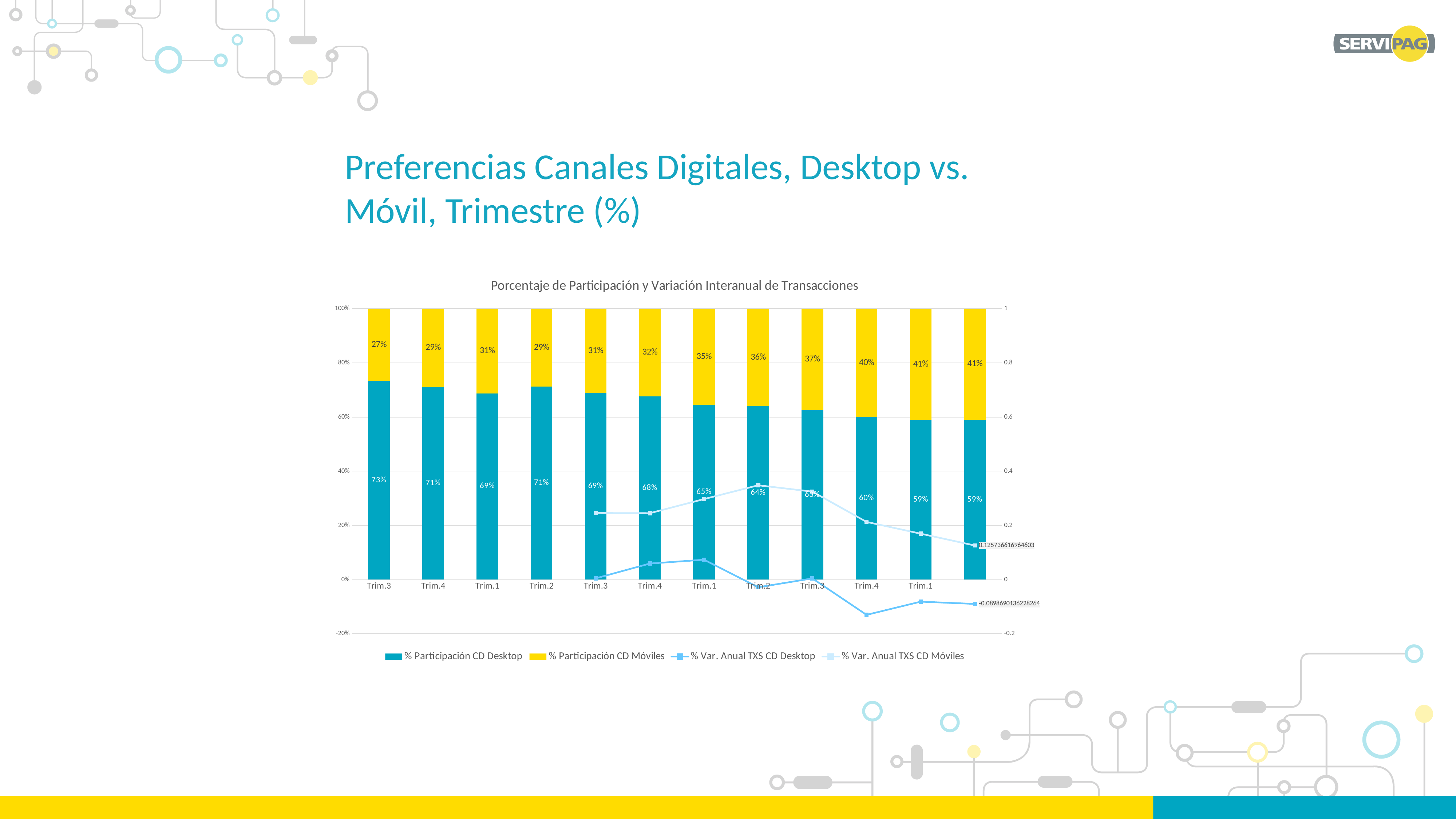
Does the % Participación CD Desktop share rise or fall from left to right across the bars? Falls Which bar has the highest % Participación CD Desktop value, and what is it? The first (leftmost) bar, 73% Which bar has the lowest % Participación CD Móviles value, and what is it? The first (leftmost) bar, 27% What is the title of the chart? Porcentaje de Participación y Variación Interanual de Transacciones How many series does the legend list? 4 What is the last data label shown for the % Var. Anual TXS CD Móviles line? 0.125736616964603 What is the % Participación CD Desktop value for the first bar (leftmost Trim.3)? 73% What is the % Participación CD Móviles value for the first bar (leftmost Trim.3)? 27% In the first (leftmost) bar, what is the difference between the Desktop share and the Móviles share? 46 percentage points What kind of chart is shown on the slide? A stacked bar chart combined with line series How many stacked bars are plotted in the chart? 12 What is the % Participación CD Móviles value for the last (rightmost) bar? 41%